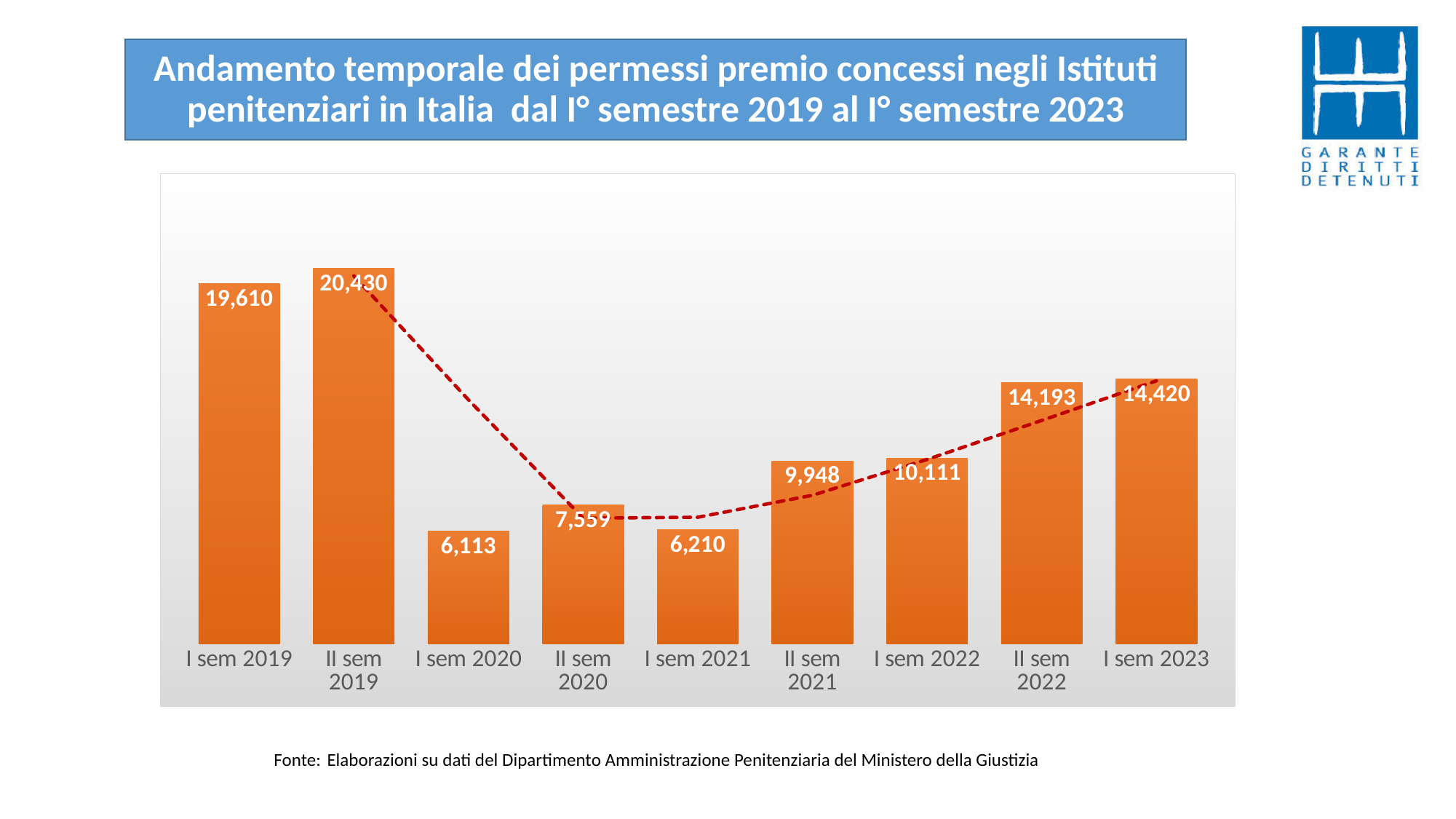
Which is larger, the value for II sem 2020 or the value for I sem 2021? II sem 2020 What is the source cited below the chart? Elaborazioni su dati del Dipartimento Amministrazione Penitenziaria del Ministero della Giustizia What is the value for II sem 2019? 20,430 Do the values rise or fall from I sem 2021 to I sem 2023? Rise What is the difference between the values for I sem 2023 and II sem 2022? 227 What kind of chart is this? Bar chart What is the difference between the values for II sem 2019 and I sem 2020? 14,317 What is the value for I sem 2023? 14,420 What is the value for I sem 2020? 6,113 Which semester has the highest value? II sem 2019 Which semester has the lowest value? I sem 2020 How many semesters are shown on the chart? 9